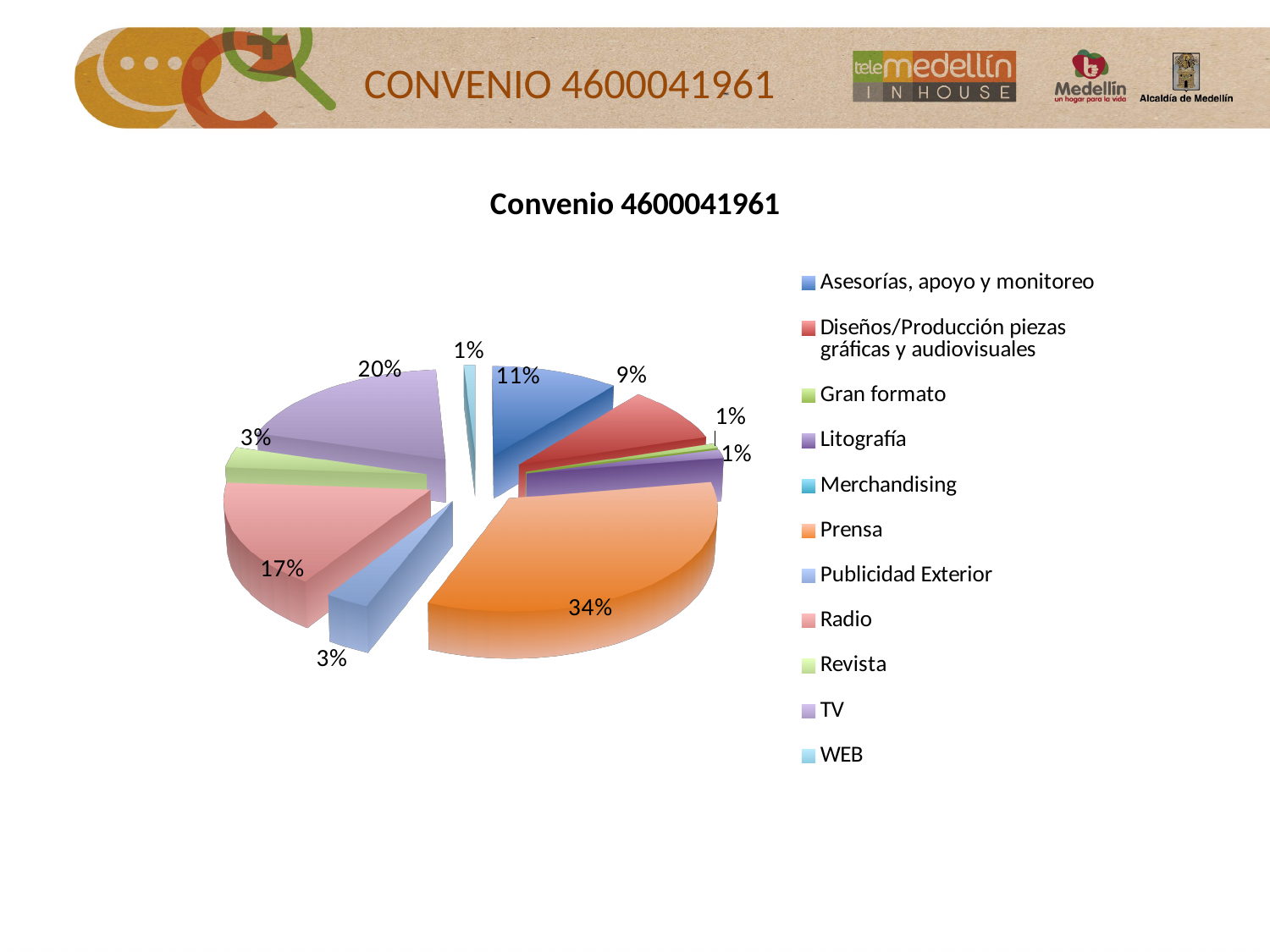
Which category has the largest slice of the pie? Prensa What is the difference in percentage points between Prensa and TV? 14 What percentage is shown for TV? 20% How many categories are listed in the legend? 11 What is the title of the chart? Convenio 4600041961 What type of chart is shown on the slide? Pie chart What percentage does Asesorías, apoyo y monitoreo account for? 11% What is the difference in percentage points between Asesorías, apoyo y monitoreo and Diseños/Producción piezas gráficas y audiovisuales? 2 What is the value for Radio? 17% What share of the pie does Prensa represent? 34% Which is larger, the share for Radio or the share for TV? TV What is the value shown for Diseños/Producción piezas gráficas y audiovisuales? 9%